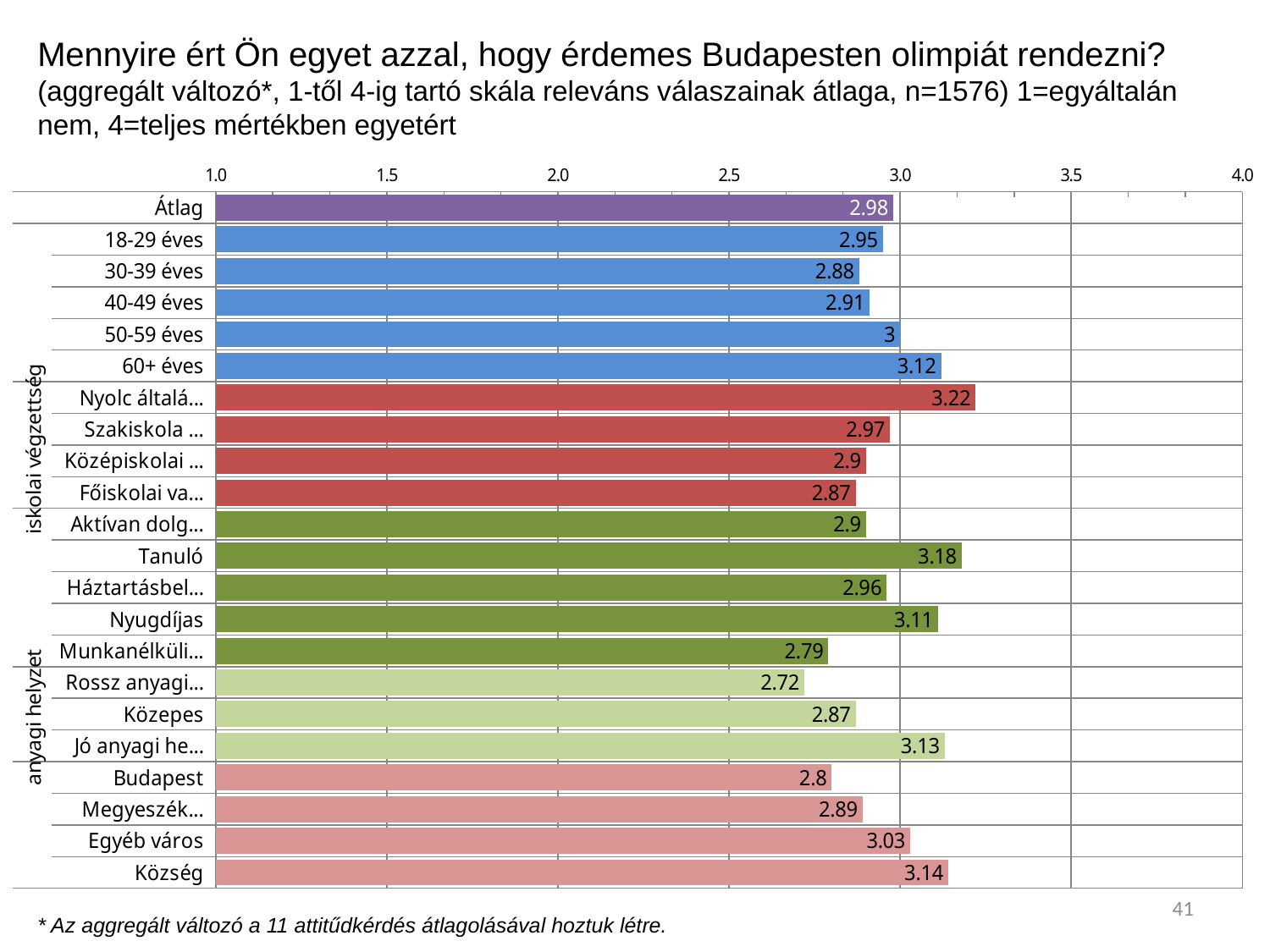
What is the value for Budapest? 2.8 What is the value for 60+ éves? 3.12 How many bars are plotted in the chart? 22 What type of chart is shown on the slide? Bar chart What is the value for Község? 3.14 What is the value for Tanuló? 3.18 What is the difference between the values for Község and Budapest? 0.34 Among the age groups (18-29 éves to 60+ éves), which has the highest value? 60+ éves Which is larger, the value for Nyugdíjas or the value for Tanuló? Tanuló Among Budapest, Egyéb város and Község, which has the highest value? Község Among the age groups (18-29 éves to 60+ éves), which has the lowest value? 30-39 éves What is the value for Átlag? 2.98